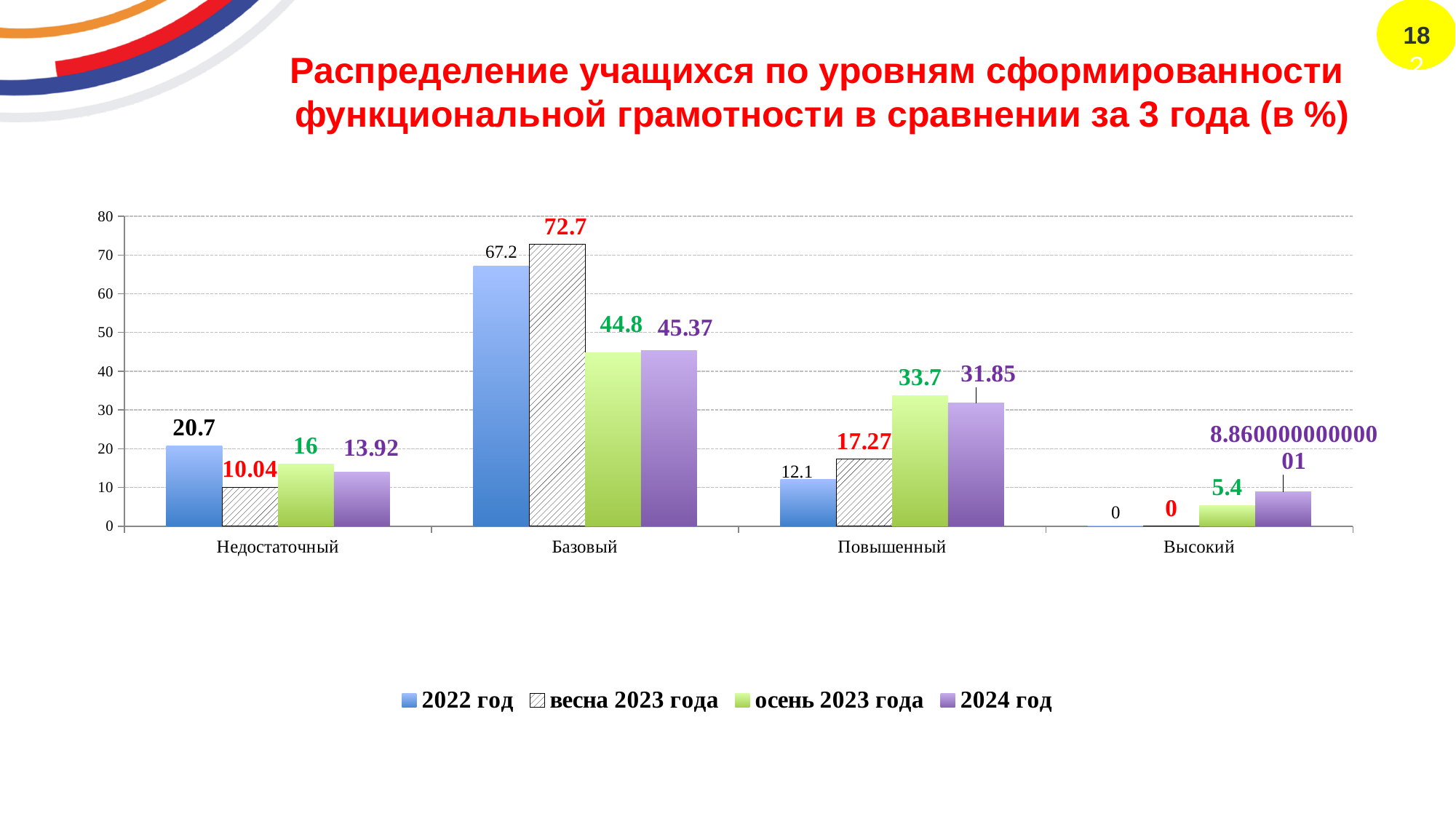
Which is larger for Повышенный: the осень 2023 года value or the 2024 год value? осень 2023 года Which category has the lowest value in the 2024 год series? Высокий What kind of chart is shown on the slide? bar chart Which category has the highest value in the весна 2023 года series? Базовый What is the value for Повышенный in the осень 2023 года series? 33.7 How many series does the legend list? 4 How many categories are shown on the x axis? 4 Is the 2024 год value for Базовый greater or less than 40? greater What is the difference between the 2022 год and весна 2023 года values for Базовый? 5.5 What is the value for Высокий in the 2024 год series? 8.86000000000001 What is the value for Недостаточный in the весна 2023 года series? 10.04 What is the value for Базовый in the 2022 год series? 67.2